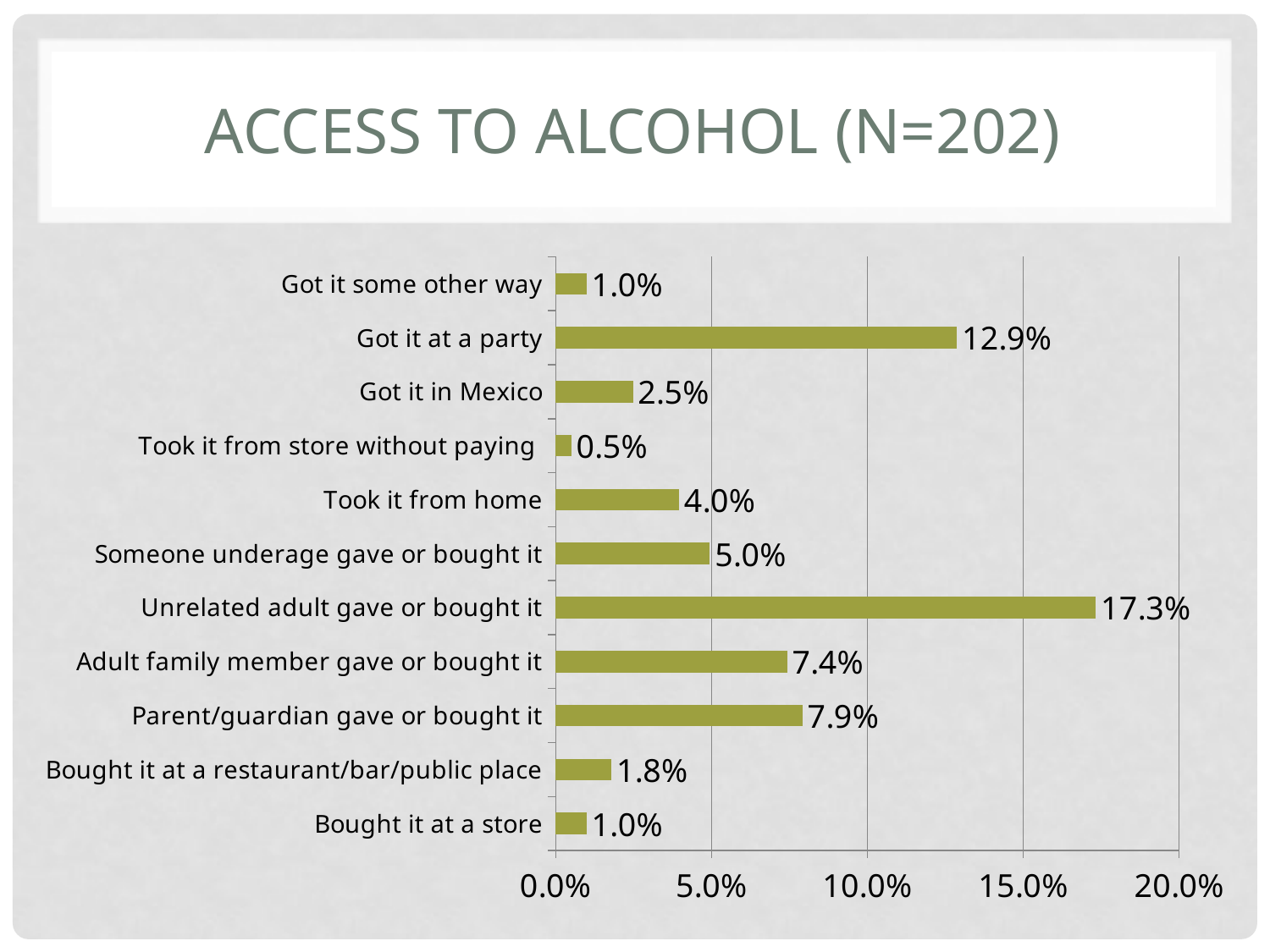
Which category has the lowest value? Took it from store without paying What percentage is shown for "Got it at a party"? 12.9% Which is larger: "Parent/guardian gave or bought it" or "Adult family member gave or bought it"? Parent/guardian gave or bought it What percentage is shown for "Bought it at a restaurant/bar/public place"? 1.8% Which category has the highest value? Unrelated adult gave or bought it What is the maximum value shown on the x axis? 20.0% What kind of chart is shown on the slide? Bar chart What is the difference between "Unrelated adult gave or bought it" and "Got it at a party"? 4.4% What is the value for "Took it from home"? 4.0% What is the title of the chart? ACCESS TO ALCOHOL (N=202) Is the value for "Adult family member gave or bought it" greater or less than 10.0%? less How many categories are shown in the chart? 11